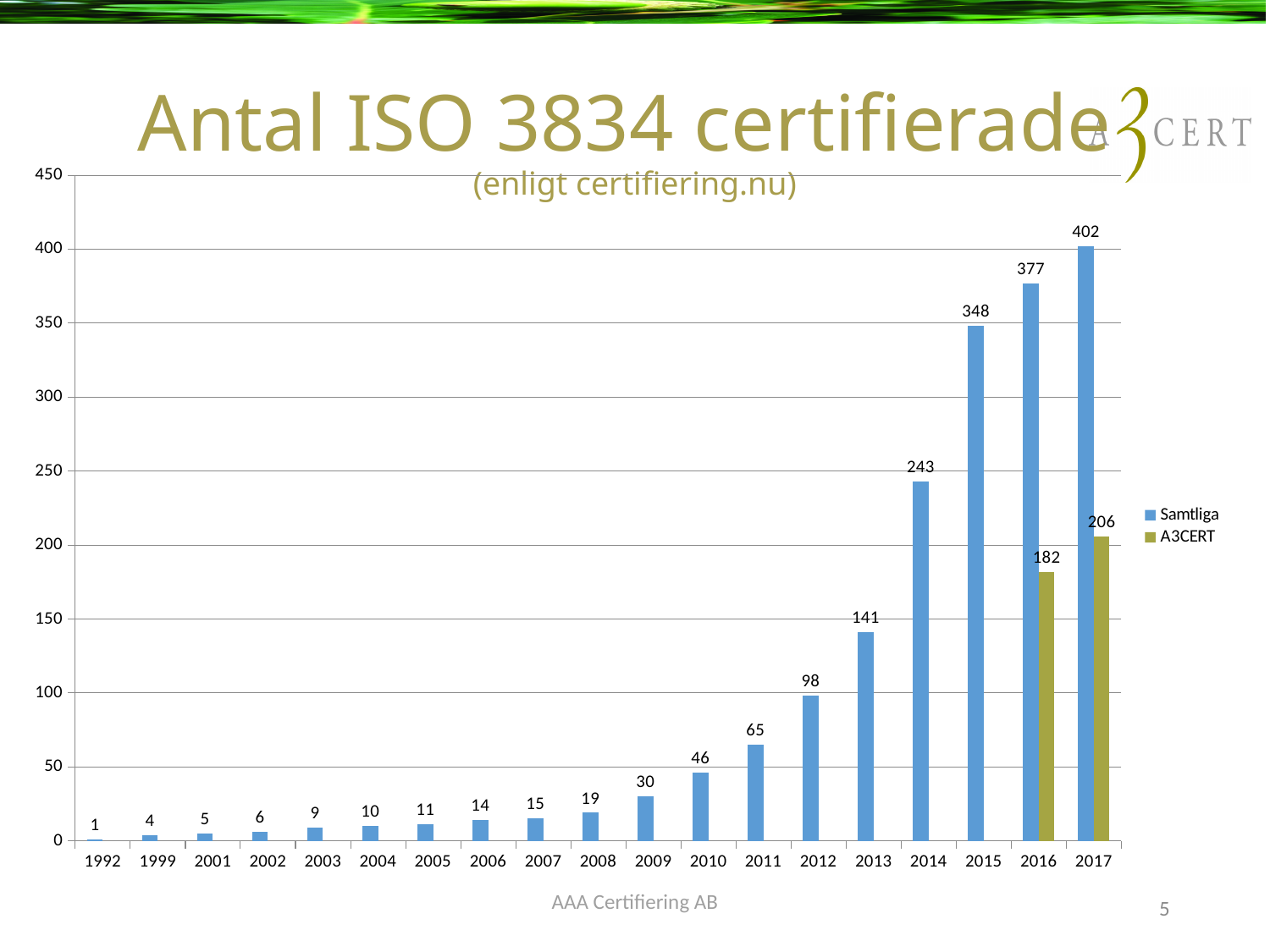
Do the Samtliga values rise or fall from 1992 to 2017? rise What is the Samtliga value for 2012? 98 What kind of chart is shown? bar chart Which year has the lowest Samtliga value? 1992 Which is larger, the Samtliga value for 2014 or for 2013? 2014 What is the Samtliga value for 2017? 402 How many series does the legend list? 2 How many years are shown on the x axis? 19 Which year has the highest Samtliga value? 2017 What is the A3CERT value for 2016? 182 What is the difference between the Samtliga values for 2017 and 2016? 25 What is the difference between the Samtliga and A3CERT values for 2017? 196